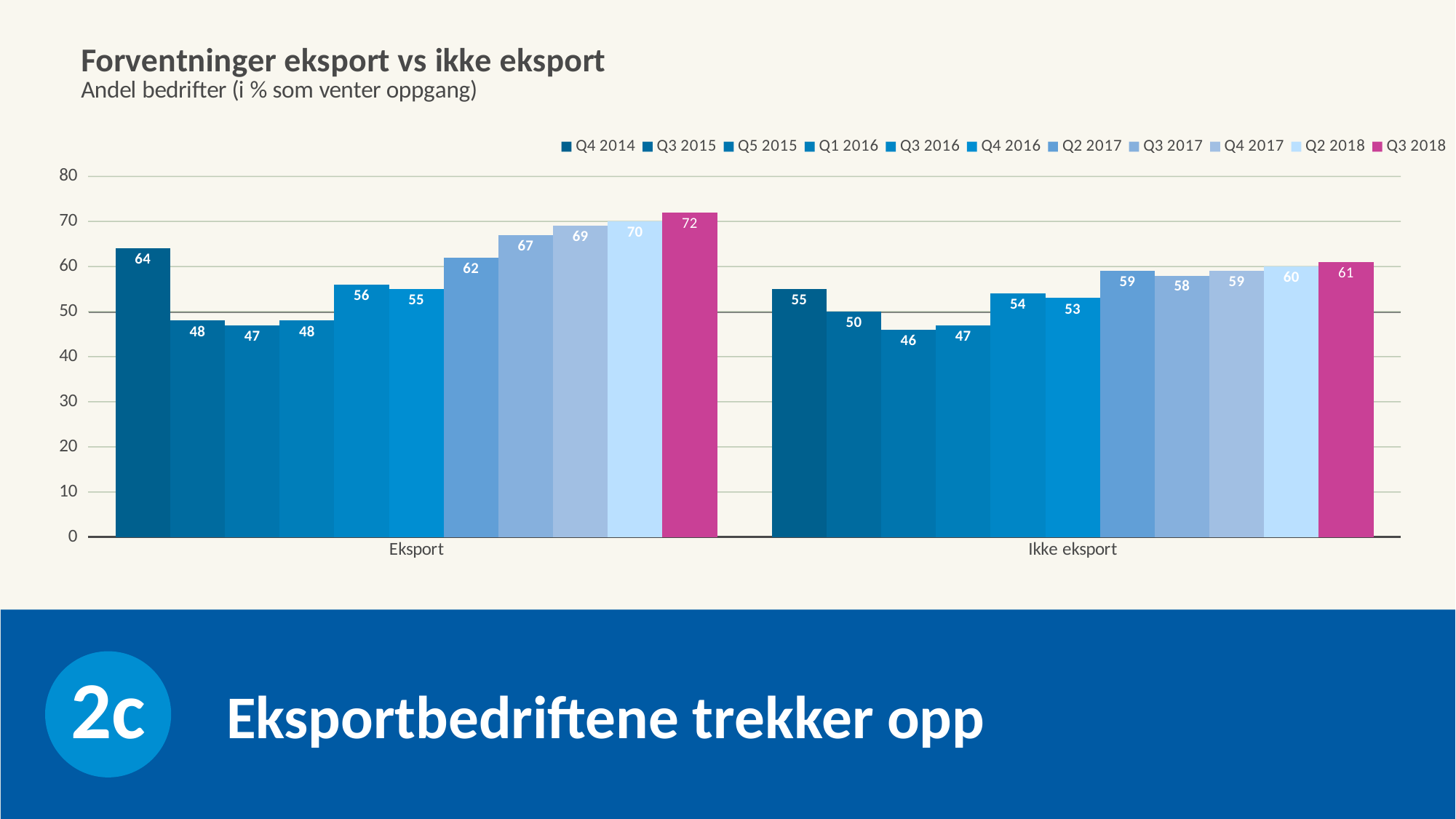
What is the difference between the Q3 2018 values for Eksport and Ikke eksport? 11 Which series has the highest value in the Eksport group? Q3 2018 Which is larger: the Q4 2014 value for Eksport or for Ikke eksport? Eksport What is the title of the chart? Forventninger eksport vs ikke eksport How many series does the legend list? 11 What is the value for Q3 2018 in the Eksport group? 72 From Q2 2017 to Q3 2018, do the values in the Eksport group rise or fall? Rise What is the value for Q2 2017 in the Eksport group? 62 Which series has the lowest value in the Ikke eksport group? Q5 2015 What is the value for Q4 2014 in the Ikke eksport group? 55 How many category groups are shown on the x axis? 2 What kind of chart is shown on the slide? Bar chart